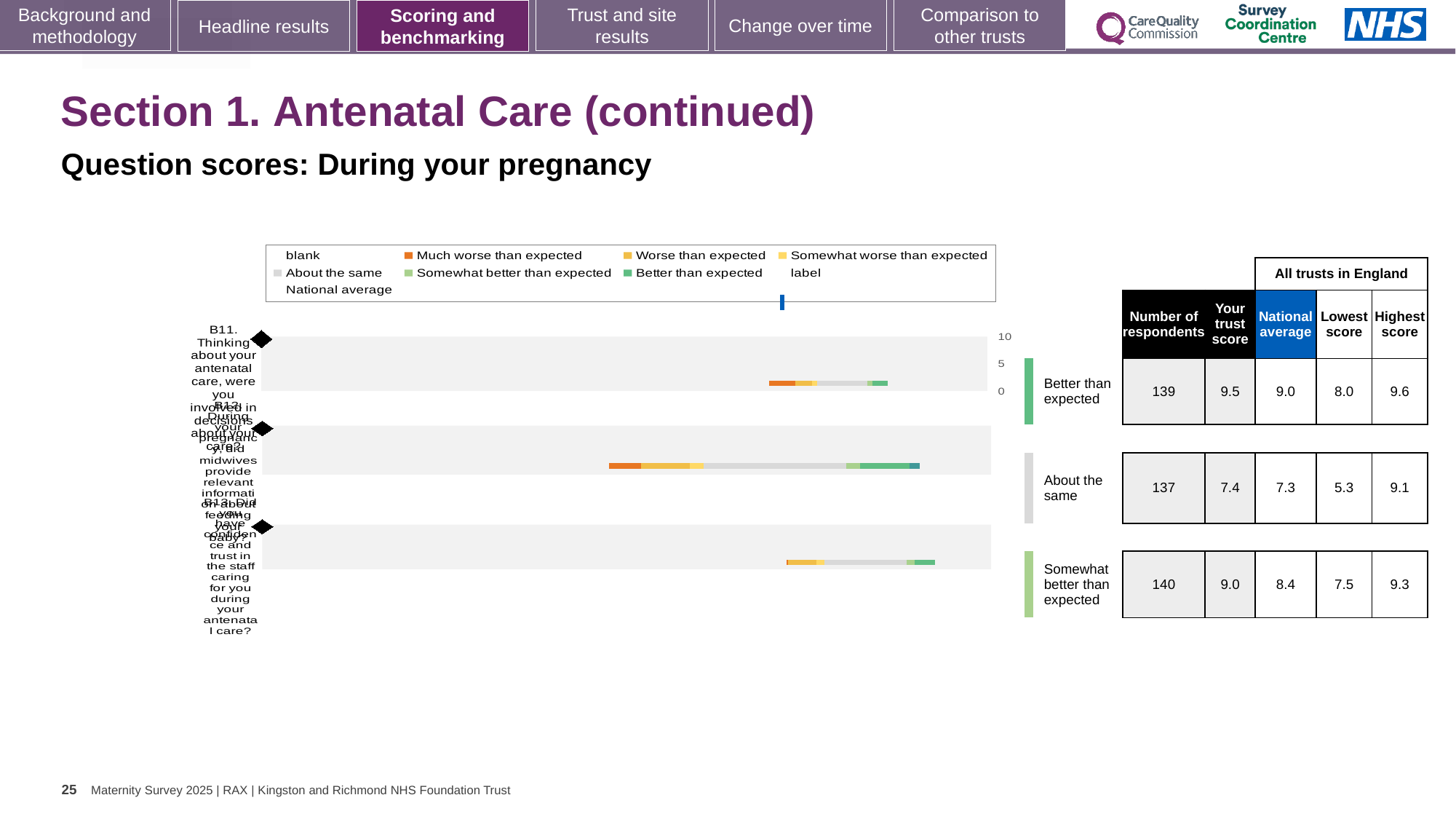
What is the number of respondents for question B11 (involved in decisions about your care)? 139 Which question has the lowest 'Lowest score' across all trusts in England? B12 For question B13, which is larger: the trust score or the national average? Trust score What is the national average for question B13 (confidence and trust in the staff caring for you)? 8.4 What is the difference between the trust score and the national average for question B11? 0.5 Which benchmark category is question B11 placed in? Better than expected What is the trust score for question B12 (midwives provide relevant information about feeding your baby)? 7.4 Which question has the highest trust score? B11 What is the highest score across all trusts in England for question B13? 9.3 How many questions (categories) are plotted in the chart? 3 What kind of chart is used to show the question scores on this slide? Bar chart Which benchmark category is question B12 placed in? About the same